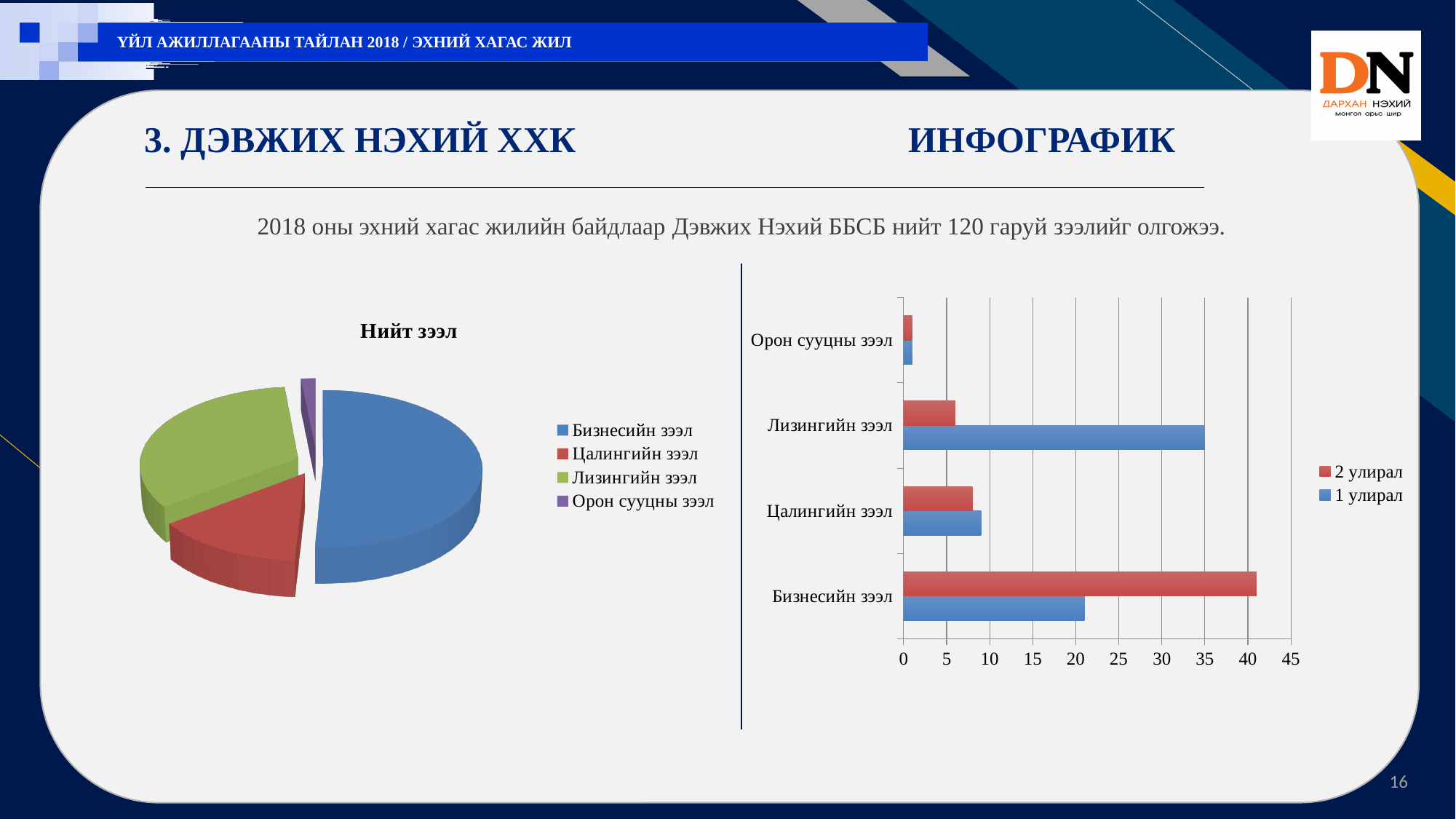
In the bar chart on the right, which category has the highest value for the "2 улирал" series? Бизнесийн зээл In the bar chart on the right, is the "1 улирал" value for Бизнесийн зээл greater or less than 30? less How many categories does the bar chart on the right show? 4 In the bar chart on the right, which category has the highest value for the "1 улирал" series? Лизингийн зээл In the bar chart on the right, for Лизингийн зээл, which series has the larger value, "1 улирал" or "2 улирал"? 1 улирал In the pie chart "Нийт зээл", which category has the smallest slice? Орон сууцны зээл What kind of chart is the chart on the right of the slide? bar chart In the bar chart on the right, is the "2 улирал" value for Бизнесийн зээл greater or less than 35? greater How many series does the legend of the bar chart on the right list? 2 What kind of chart is the chart titled "Нийт зээл" on the left of the slide? pie chart In the pie chart "Нийт зээл", which category has the largest slice? Бизнесийн зээл How many categories does the pie chart "Нийт зээл" show? 4